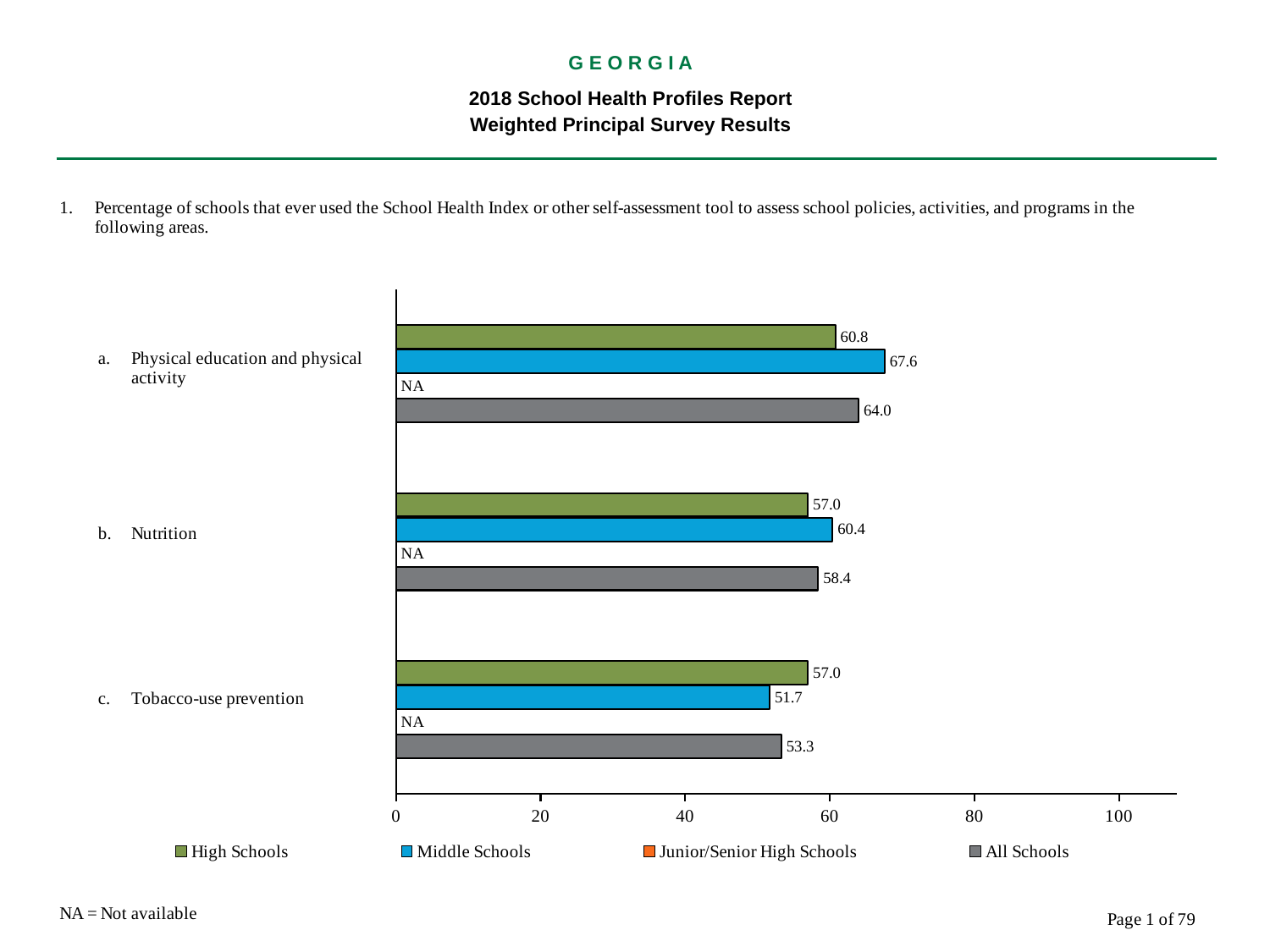
Which category has the lowest value for All Schools? Tobacco-use prevention How many categories are shown on the chart? 3 Is the value for Middle Schools for Nutrition greater or less than 80? less What is the value for High Schools for Tobacco-use prevention? 57.0 How many series does the legend list? 4 What is shown in place of a bar for Junior/Senior High Schools in each category? NA For Tobacco-use prevention, which is larger: the High Schools value or the Middle Schools value? High Schools What is the difference between the Middle Schools and High Schools values for Physical education and physical activity? 6.8 What is the value for All Schools for Nutrition? 58.4 What is the value for Middle Schools for Physical education and physical activity? 67.6 Which category has the highest value for Middle Schools? Physical education and physical activity What kind of chart is shown on the slide? bar chart